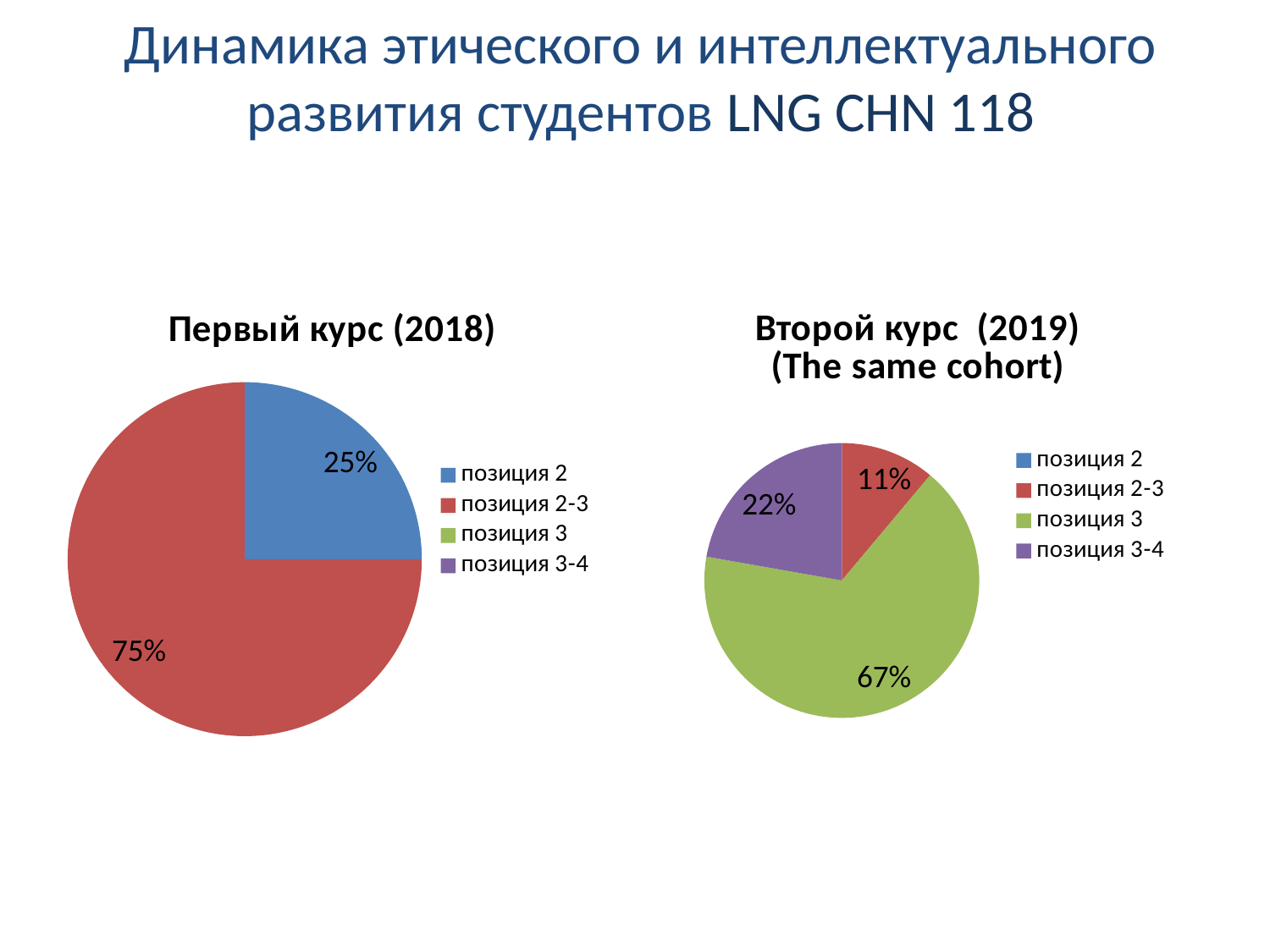
In the 'Второй курс (2019)' chart, which category has the largest slice? позиция 3 In the 'Первый курс (2018)' chart, which category has the largest slice? позиция 2-3 In the 'Первый курс (2018)' chart, what share does 'позиция 2' have? 25% In the 'Первый курс (2018)' chart, what is the difference between the shares of 'позиция 2-3' and 'позиция 2'? 50% In the 'Второй курс (2019)' chart, what share does 'позиция 3' have? 67% In the 'Второй курс (2019)' chart, what share does 'позиция 2-3' have? 11% What type of chart is used on the left side of the slide, titled 'Первый курс (2018)'? Pie chart In the 'Первый курс (2018)' chart, what share does 'позиция 2-3' have? 75% In the 'Второй курс (2019)' chart, what share does 'позиция 3-4' have? 22% In the 'Второй курс (2019)' chart, which category has the smallest slice? позиция 2-3 In the 'Второй курс (2019)' chart, what is the difference between the shares of 'позиция 3' and 'позиция 3-4'? 45% How many entries does the legend of the 'Второй курс (2019)' chart list? 4